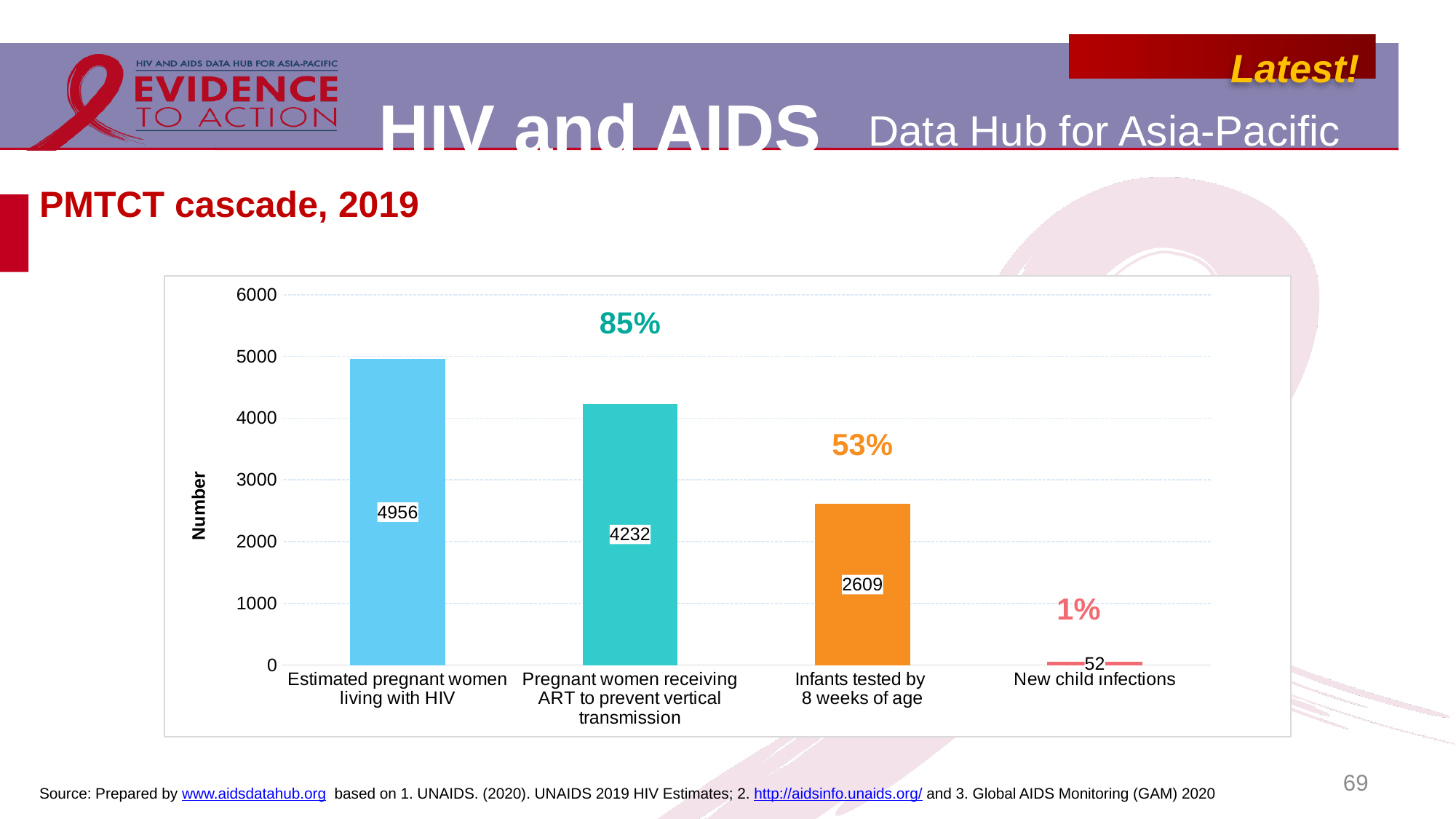
What is the value for Estimated pregnant women living with HIV? 4956 What kind of chart is this? Bar chart What is the difference between Estimated pregnant women living with HIV and Pregnant women receiving ART to prevent vertical transmission? 724 How many categories are shown on the x axis? 4 What is the difference between Pregnant women receiving ART to prevent vertical transmission and Infants tested by 8 weeks of age? 1623 Which category has the highest value? Estimated pregnant women living with HIV What is the value for Pregnant women receiving ART to prevent vertical transmission? 4232 What percentage is printed above the Infants tested by 8 weeks of age bar? 53% Which category has the lowest value? New child infections Which is larger: Infants tested by 8 weeks of age or New child infections? Infants tested by 8 weeks of age What is the value for Infants tested by 8 weeks of age? 2609 What is the value for New child infections? 52